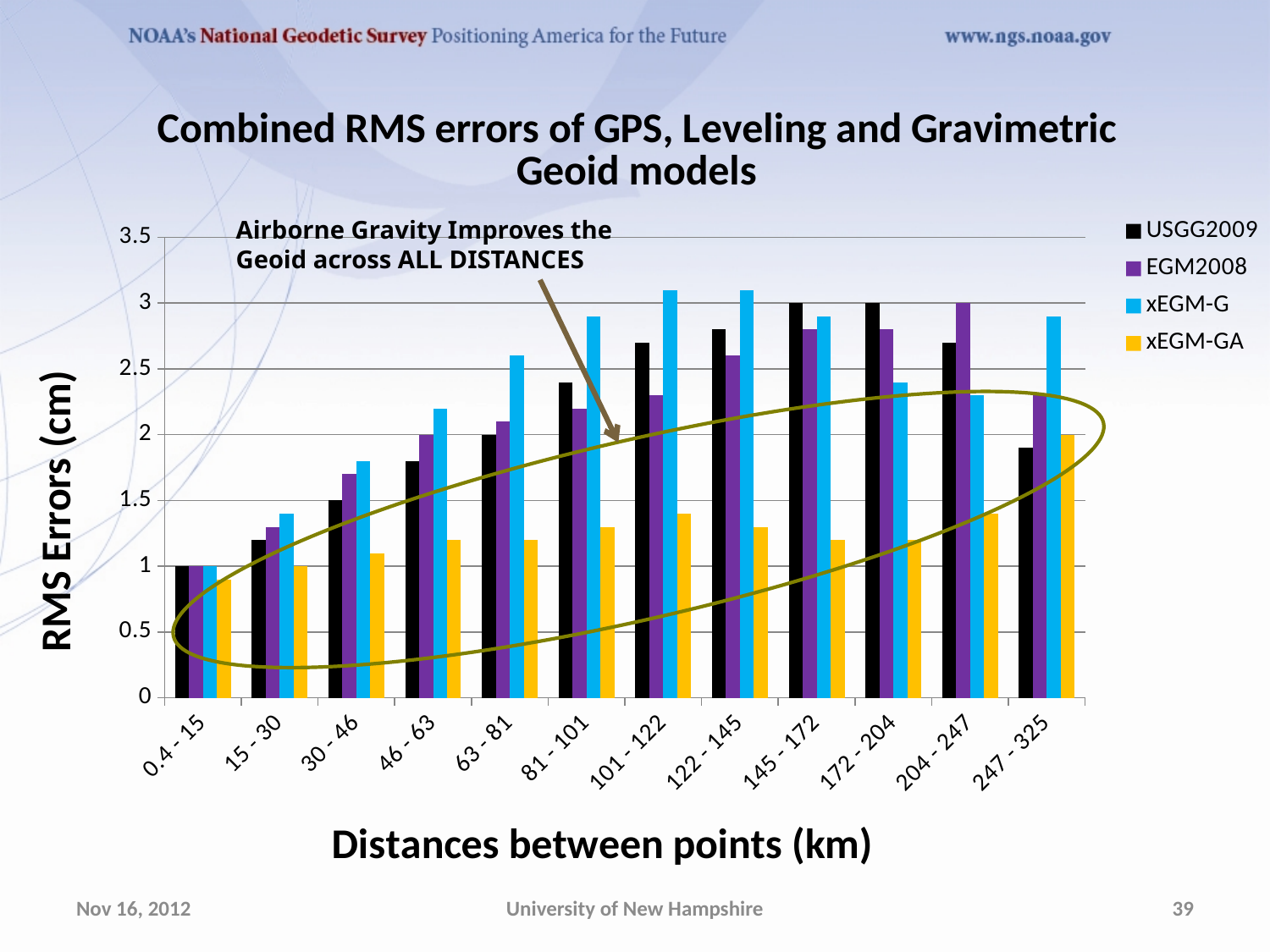
At the 204 - 247 km distance, which is larger: EGM2008 or xEGM-G? EGM2008 Is the value for xEGM-G at 101 - 122 km greater or less than 3? greater What is the RMS error for xEGM-GA at the 247 - 325 km distance? 2 Which series has the lowest RMS error at the 145 - 172 km distance? xEGM-GA How many series does the legend list? 4 Which series has the highest RMS error at the 122 - 145 km distance? xEGM-G Is the value for xEGM-GA at 81 - 101 km greater or less than 1.5? less What is the title of the y axis? RMS Errors (cm) How many distance categories are shown on the x axis? 12 What is the RMS error for USGG2009 at the 145 - 172 km distance? 3 Do the xEGM-G values rise or fall from 0.4 - 15 km to 122 - 145 km? rise What kind of chart is shown on the slide? bar chart